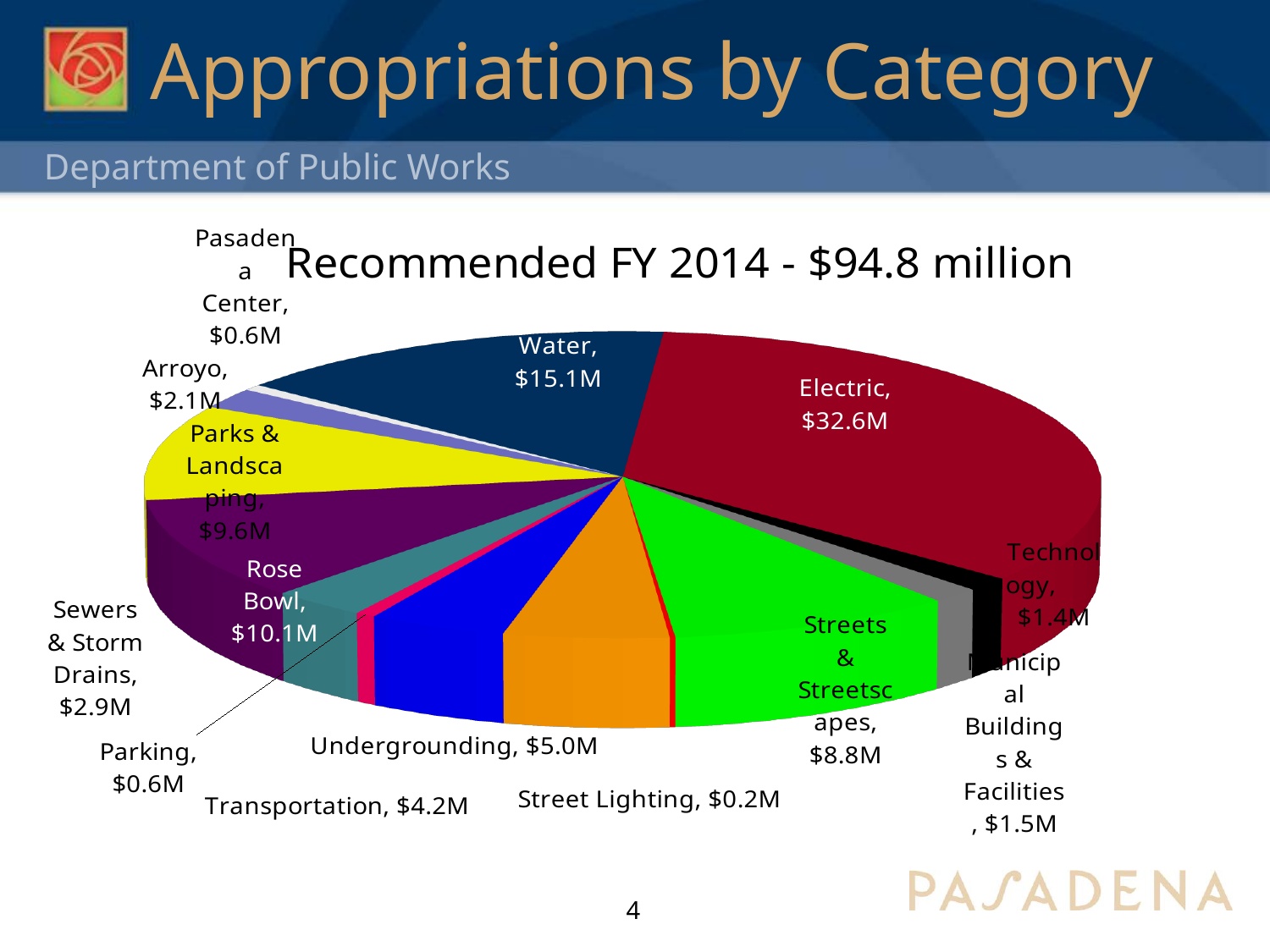
What is the difference between the Electric and Water appropriations? $17.5M What is the appropriation for Rose Bowl? $10.1M What is the appropriation for Water? $15.1M What type of chart is shown on the slide? Pie chart What is the appropriation for Electric? $32.6M How many categories are shown in the pie chart? 14 Which is larger, the appropriation for Rose Bowl or for Parks & Landscaping? Rose Bowl Which category has the smallest appropriation? Street Lighting What is the title of the chart? Recommended FY 2014 - $94.8 million What is the difference between the Water and Streets & Streetscapes appropriations? $6.3M What is the appropriation for Undergrounding? $5.0M Which category has the largest appropriation? Electric